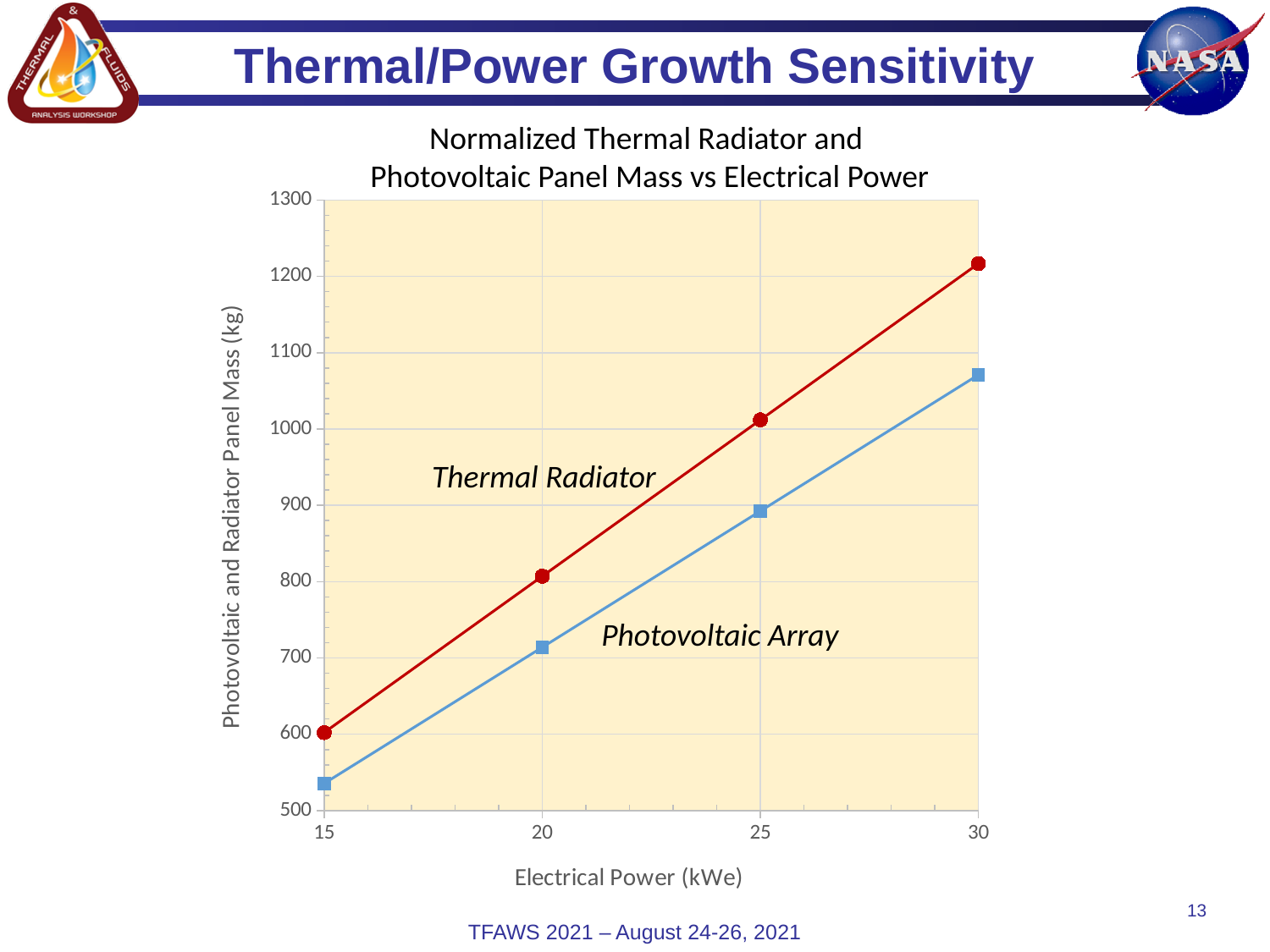
How many series are plotted on the chart? 2 What is the label of the x axis? Electrical Power (kWe) Is the Photovoltaic Array mass at 30 kWe greater or less than 1100? less What is the title of the chart? Normalized Thermal Radiator and Photovoltaic Panel Mass vs Electrical Power Is the Thermal Radiator mass at 30 kWe greater or less than 1200? greater Does the Photovoltaic Array mass rise or fall as electrical power increases? rise At which electrical power is the Photovoltaic Array mass lowest? 15 At which electrical power is the Thermal Radiator mass highest? 30 How many data points does the Thermal Radiator series have? 4 What kind of chart is shown on the slide? line chart Which series has the higher mass at 25 kWe, Thermal Radiator or Photovoltaic Array? Thermal Radiator